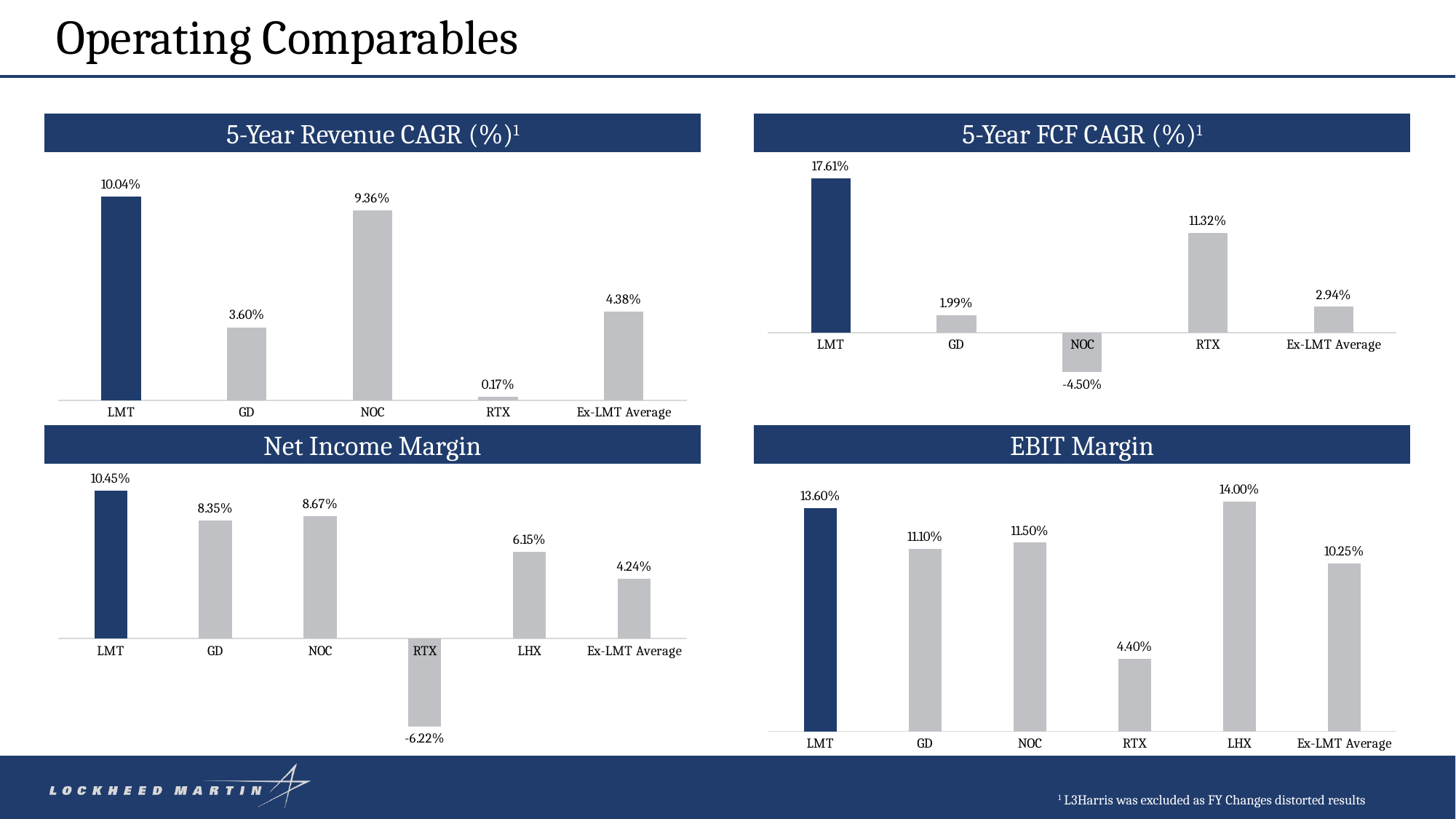
In the Net Income Margin chart, how many categories are shown? 6 What kind of chart is the 5-Year Revenue CAGR (%) chart? Bar chart In the 5-Year FCF CAGR (%) chart, what is the difference between the LMT value and the RTX value? 6.29% In the Net Income Margin chart, what is the value for LHX? 6.15% In the 5-Year Revenue CAGR (%) chart, what is the value for NOC? 9.36% In the EBIT Margin chart, which category has the highest value? LHX In the 5-Year Revenue CAGR (%) chart, which category has the lowest value? RTX In the Net Income Margin chart, which is larger, the value for GD or the value for NOC? NOC In the EBIT Margin chart, what is the value for Ex-LMT Average? 10.25% In the 5-Year FCF CAGR (%) chart, which category has the highest value? LMT In the EBIT Margin chart, what is the difference between the LHX value and the RTX value? 9.60% In the 5-Year FCF CAGR (%) chart, what is the value for NOC? -4.50%